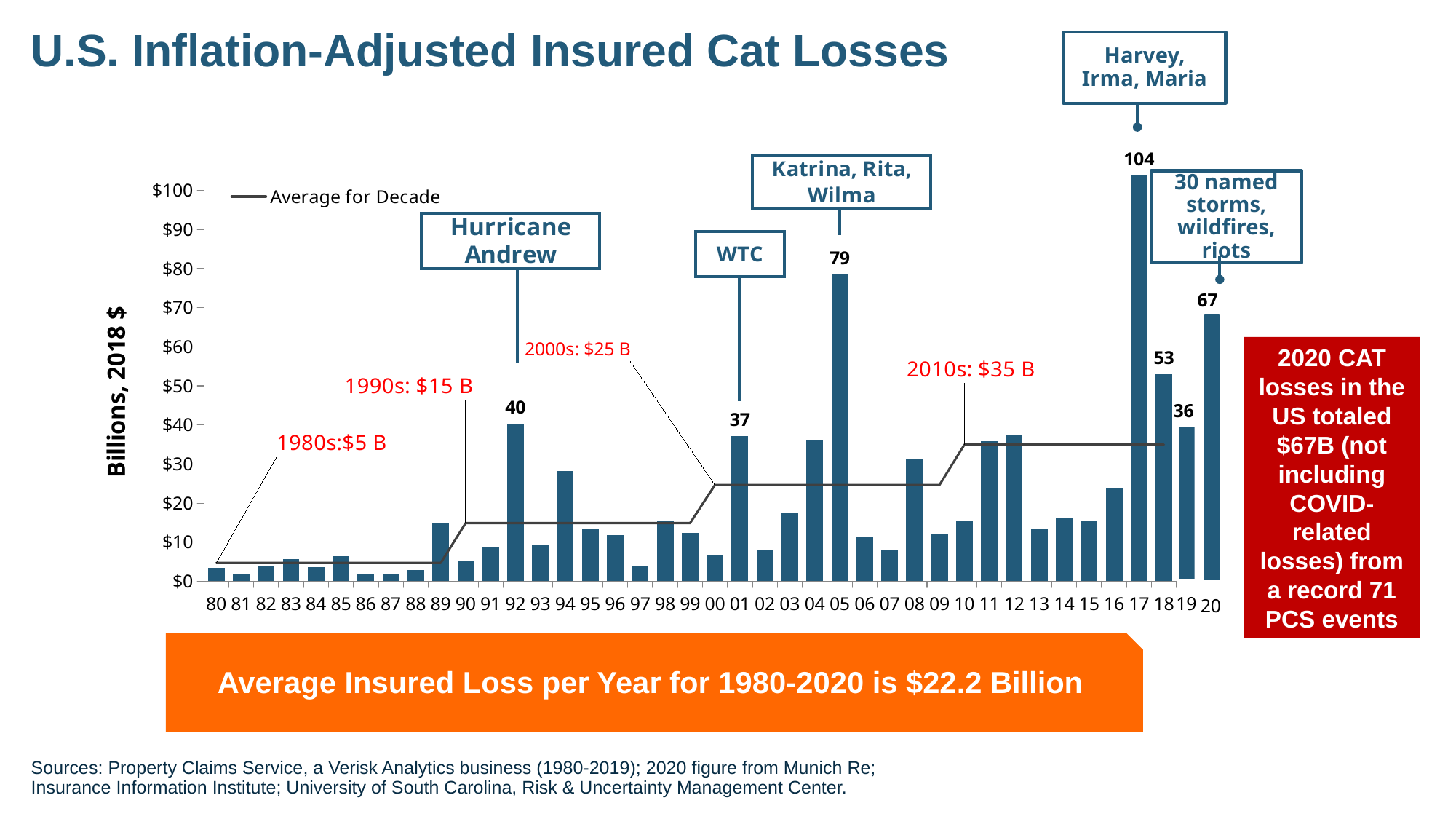
Which year has the highest insured cat losses? 17 What is the difference between the values for 2017 and 2020? 37 Which is larger, the value for 2018 or the value for 2020? 2020 What is the value for 1992 (label 92)? 40 What is the value for 2017 (label 17)? 104 Is the value for 2016 (label 16) greater or less than $30? less What kind of chart is this? bar chart What is the decade average shown for the 1990s? $15 B How many years (bars) are shown on the x axis? 41 Is the value for 2014 (label 14) greater or less than $20? less What is the difference between the values for 2005 and 2001? 42 What is the value for 2005 (label 05)? 79